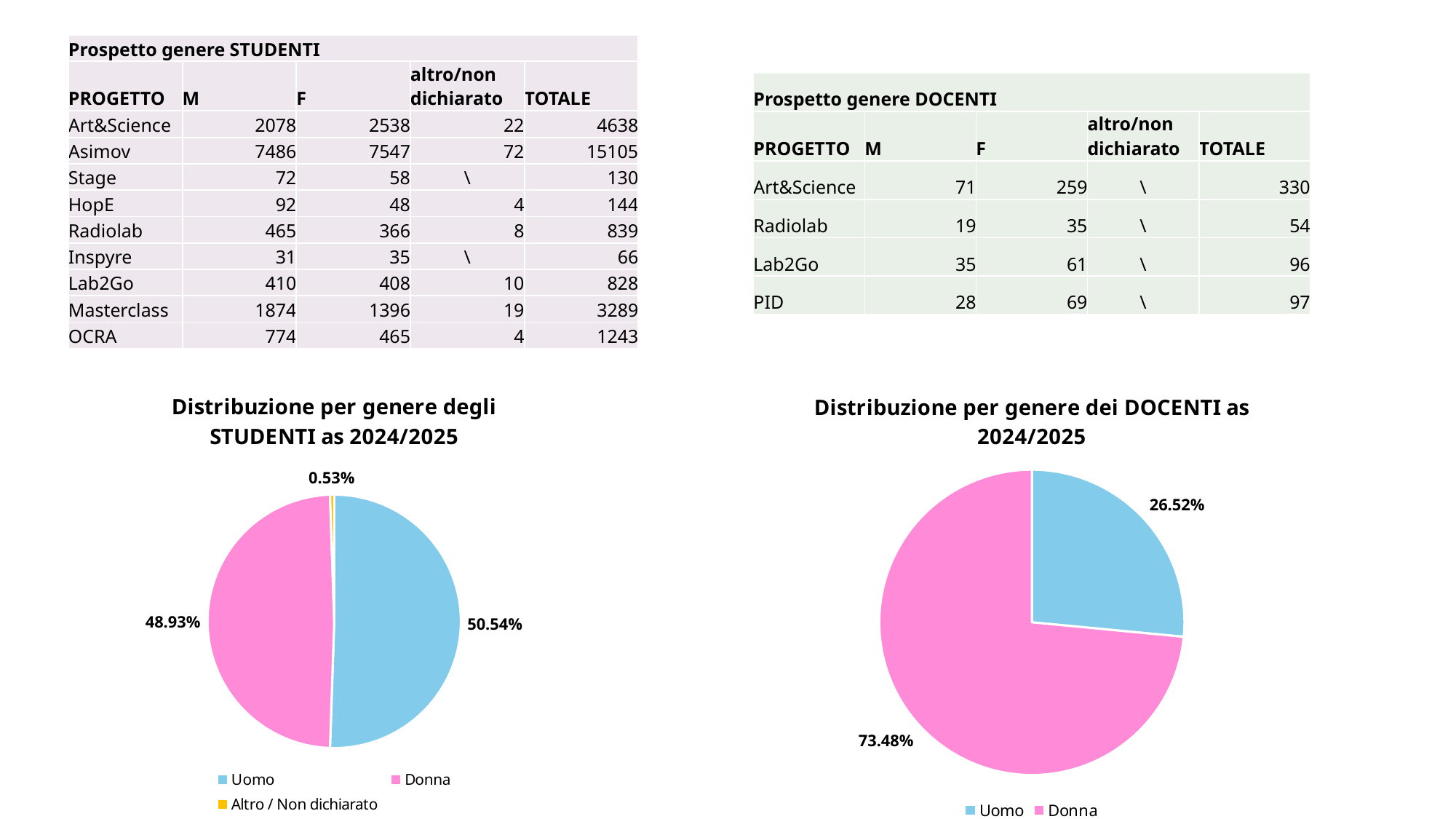
In the chart 'Distribuzione per genere degli STUDENTI as 2024/2025', what share is labelled for Uomo? 50.54% In the chart 'Distribuzione per genere degli STUDENTI as 2024/2025', what share is labelled for Altro / Non dichiarato? 0.53% In the chart 'Distribuzione per genere degli STUDENTI as 2024/2025', what is the difference between the Uomo and Donna shares? 1.61% In the chart 'Distribuzione per genere degli STUDENTI as 2024/2025', what share is labelled for Donna? 48.93% How many categories does the legend of the chart 'Distribuzione per genere degli STUDENTI as 2024/2025' list? 3 In the chart 'Distribuzione per genere degli STUDENTI as 2024/2025', which category has the smallest slice? Altro / Non dichiarato In the chart 'Distribuzione per genere dei DOCENTI as 2024/2025', what share is labelled for Donna? 73.48% In the chart 'Distribuzione per genere dei DOCENTI as 2024/2025', what is the difference between the Donna and Uomo shares? 46.96% In the chart 'Distribuzione per genere dei DOCENTI as 2024/2025', which category has the largest slice? Donna In the chart 'Distribuzione per genere dei DOCENTI as 2024/2025', what share is labelled for Uomo? 26.52% What type of chart is 'Distribuzione per genere dei DOCENTI as 2024/2025'? pie chart How many categories does the legend of the chart 'Distribuzione per genere dei DOCENTI as 2024/2025' list? 2